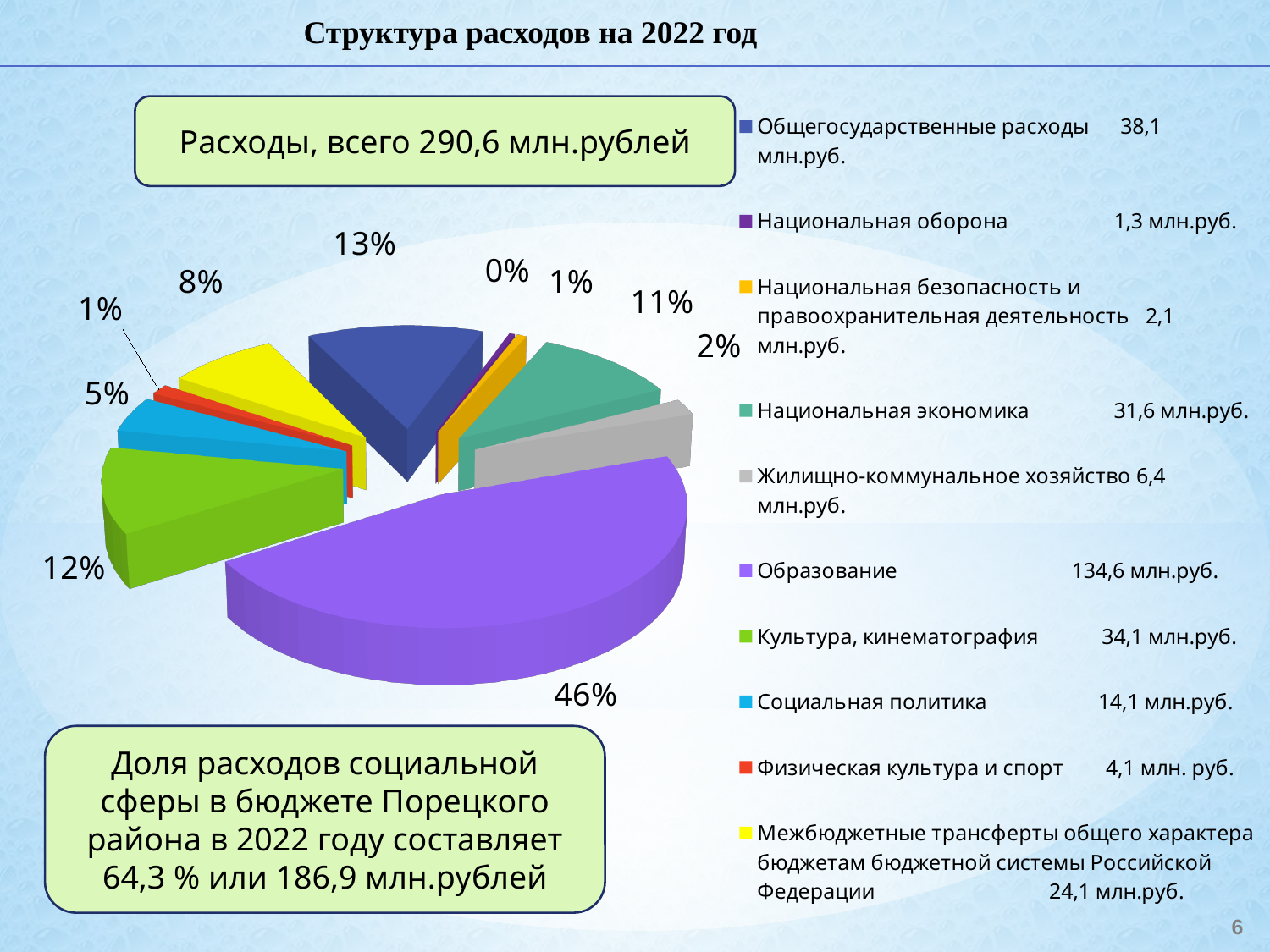
How many categories does the legend of the pie chart list? 10 What share of the pie does Образование account for? 46% Which is larger: Общегосударственные расходы or Национальная экономика? Общегосударственные расходы What is the difference between the values for Общегосударственные расходы (38,1) and Национальная экономика (31,6)? 6,5 млн.руб. What is the value shown in the legend for Национальная экономика? 31,6 млн.руб. Which category has the smallest slice of the pie? Национальная оборона What kind of chart is shown on the slide? pie chart What share of the pie does Общегосударственные расходы account for? 13% Which category has the largest slice of the pie? Образование What share of the pie does Культура, кинематография account for? 12% What is the title of the slide containing the pie chart? Структура расходов на 2022 год What is the value shown in the legend for Социальная политика? 14,1 млн.руб.